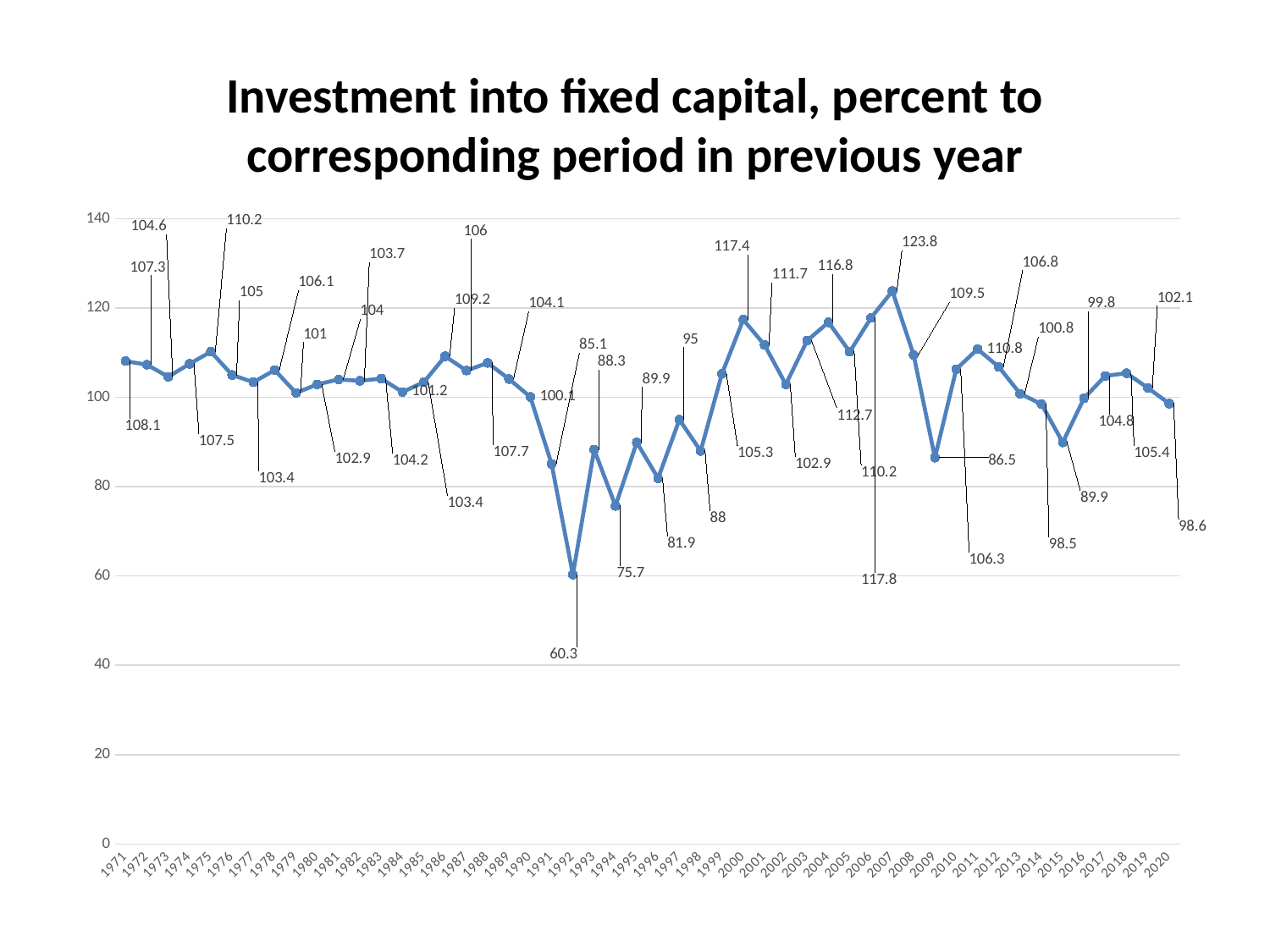
What is the value for 2020? 98.6 Which year has the larger value, 2000 or 2001? 2000 Do the values rise or fall from 2007 to 2009? fall Which year has the lowest value on the chart? 1992 Is the value for 1994 greater or less than 80? less Which year has the highest value on the chart? 2007 What is the value for 2007? 123.8 What is the value for 1971? 108.1 What is the title of the chart? Investment into fixed capital, percent to corresponding period in previous year What kind of chart is shown on the slide? line chart What is the difference between the highest value (2007) and the lowest value (1992)? 63.5 What is the value for 1992? 60.3